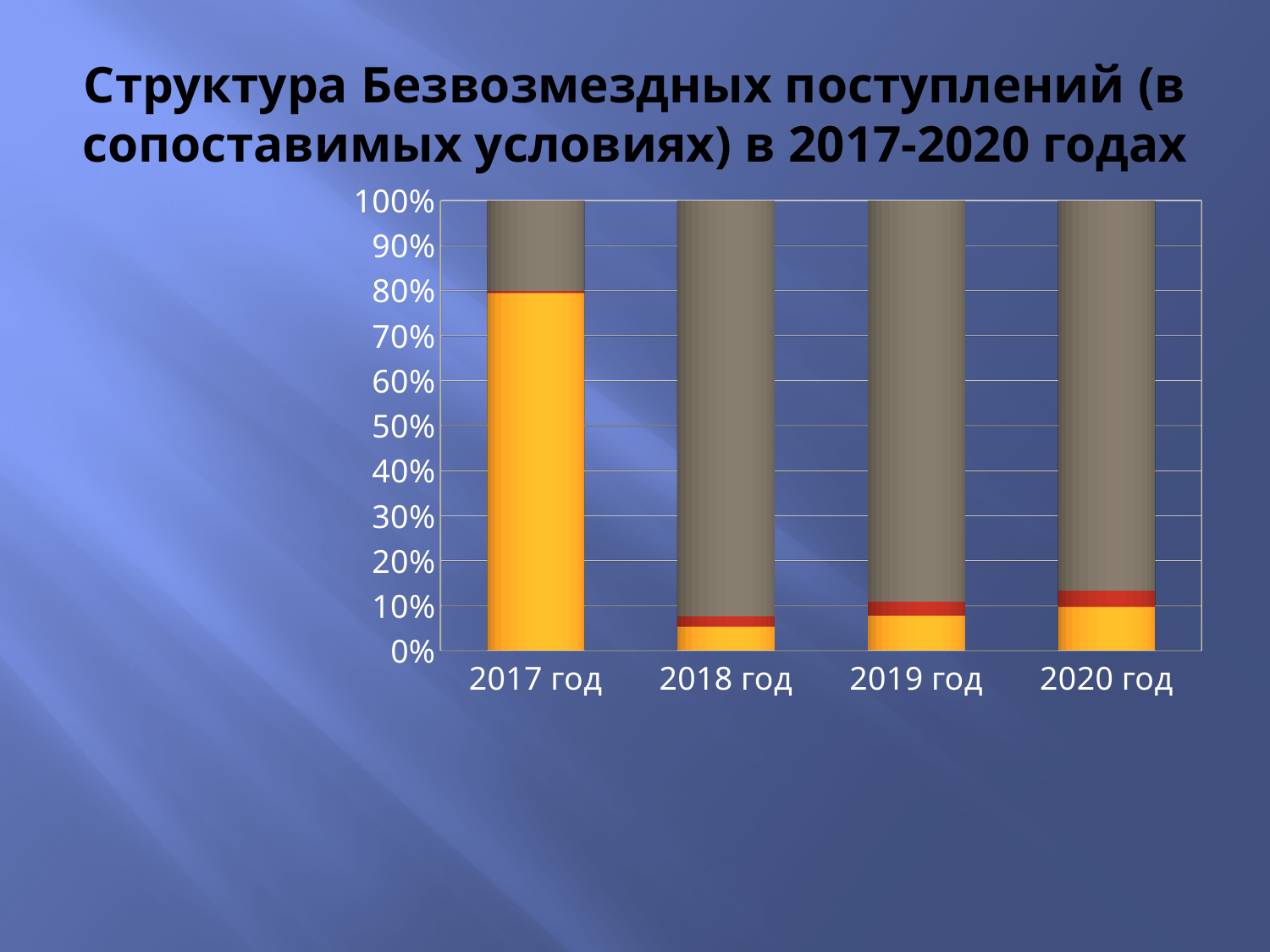
Which year has the larger yellow segment, 2017 год or 2020 год? 2017 год Is the yellow segment for 2018 год greater or less than 10%? less What is the title of the chart on the slide? Структура Безвозмездных поступлений (в сопоставимых условиях) в 2017-2020 годах Is the grey segment for 2019 год greater or less than 80%? greater Which year has the smallest yellow segment in the chart? 2018 год Is the grey segment for 2017 год greater or less than 30%? less What kind of chart is shown on the slide? stacked bar chart Which year has the largest yellow segment in the chart? 2017 год Does the yellow segment rise or fall from 2018 год to 2020 год? rise How many differently coloured segments make up each bar in the chart? 3 How many years (categories) are shown on the x axis of the chart? 4